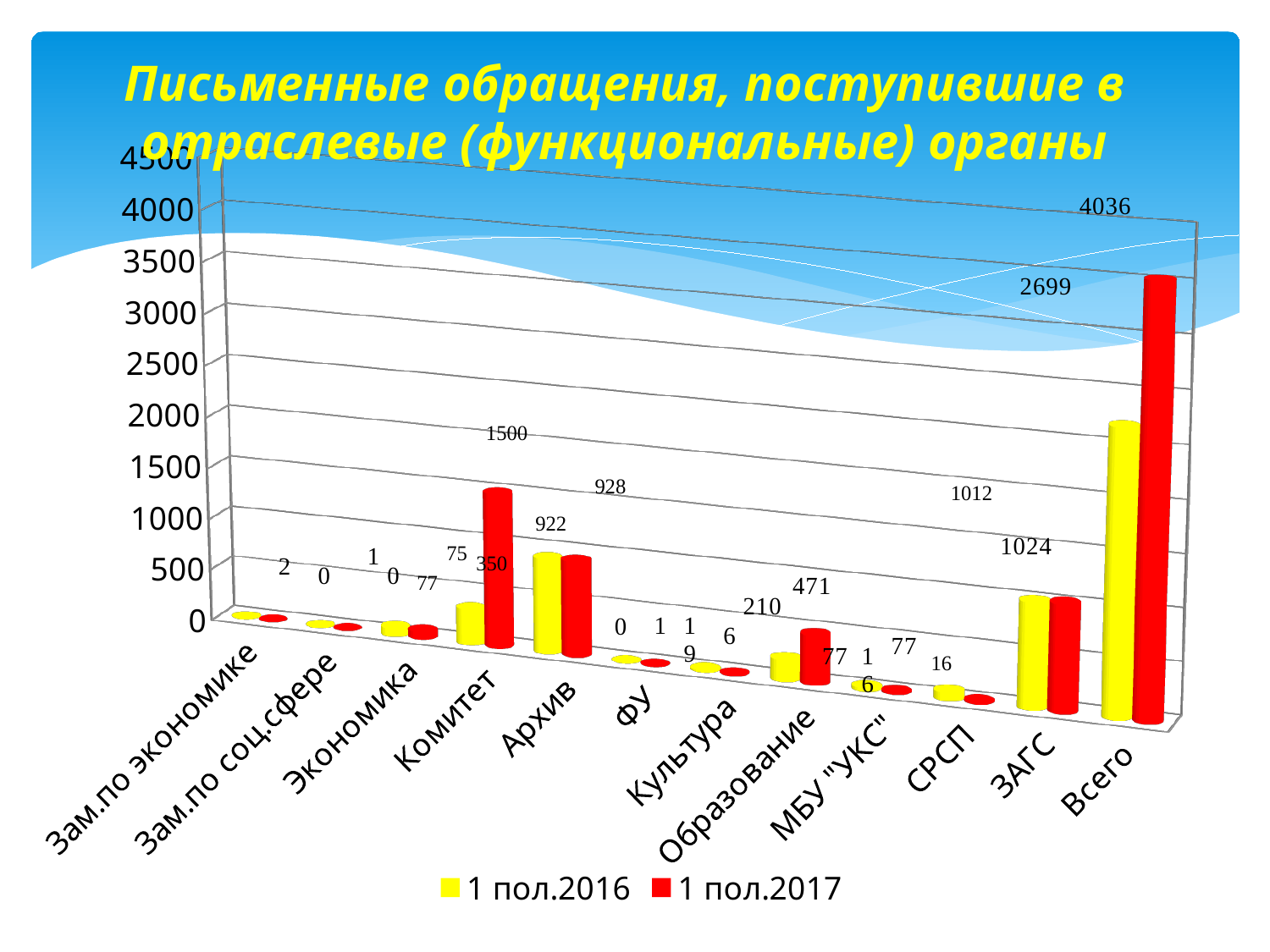
What kind of chart is shown on the slide? Bar chart How many series does the legend list? 2 What is the value for Образование in the 1 пол.2017 series? 471 Which category has the highest value in the 1 пол.2017 series? Всего Which is larger for Комитет: the 1 пол.2016 value or the 1 пол.2017 value? 1 пол.2017 What is the value for ЗАГС in the 1 пол.2016 series? 1012 What is the value for Комитет in the 1 пол.2017 series? 1500 How many categories are shown on the x axis? 12 What is the value for Всего in the 1 пол.2017 series? 4036 What is the value for Архив in the 1 пол.2017 series? 928 What is the value for Всего in the 1 пол.2016 series? 2699 What is the difference between the 1 пол.2017 and 1 пол.2016 values for Всего? 1337